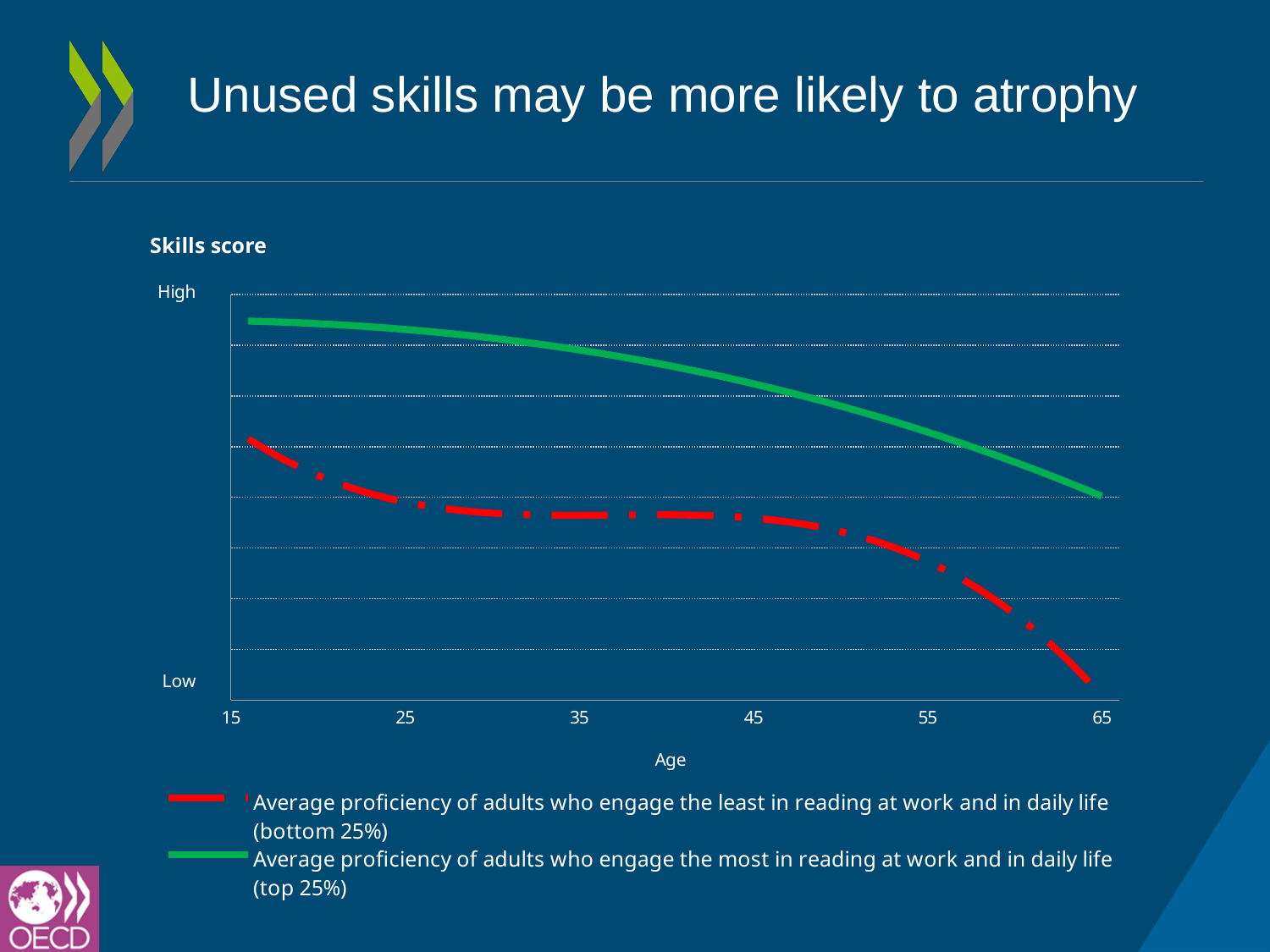
What is the lowest age shown on the x axis? 15 What is the label above the y axis of the chart? Skills score Which series has the higher skills score at age 65: the top 25% or the bottom 25% of readers? top 25% What is the highest age shown on the x axis? 65 Does the skills score for adults who engage the most in reading (top 25%) rise or fall as age increases? fall How many series does the legend list? 2 What colour is the line for adults who engage the least in reading at work and in daily life (bottom 25%)? red What is the title of the slide? Unused skills may be more likely to atrophy What kind of chart is shown on the slide? line chart Which series has the higher skills score at age 25: the top 25% or the bottom 25% of readers? top 25% Does the skills score for adults who engage the least in reading (bottom 25%) rise or fall as age increases? fall